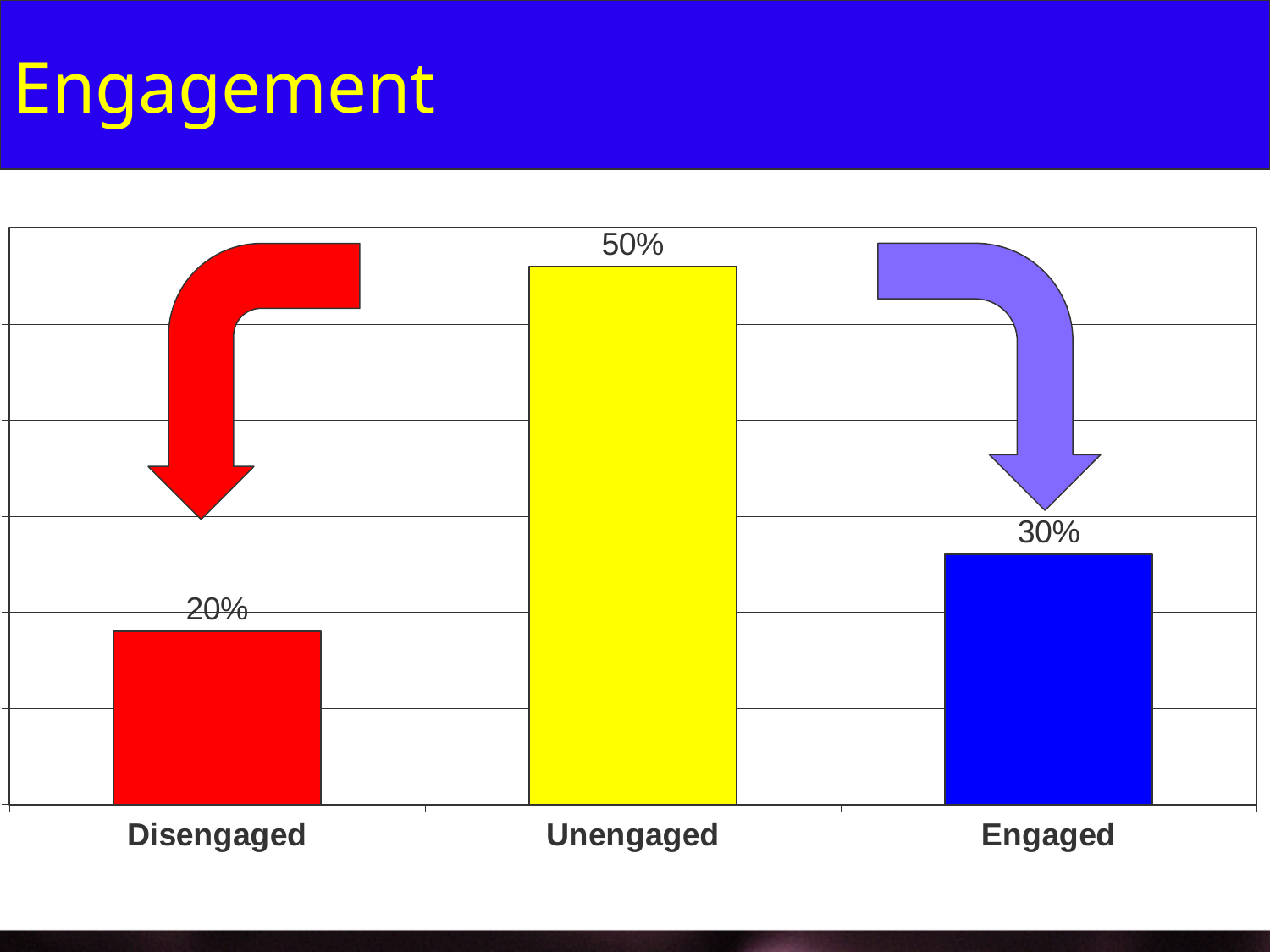
Which category has the lowest value? Disengaged How many categories are shown in the chart? 3 Which category has the highest value? Unengaged What is the difference between the Engaged and Disengaged values? 10% What kind of chart is shown on the slide? Bar chart What is the value for Engaged? 30% What is the difference between the Unengaged and Engaged values? 20% Which is larger, the value for Engaged or the value for Disengaged? Engaged What is the title of the slide containing the chart? Engagement What colour is the bar for Unengaged? Yellow What is the value for Unengaged? 50% What is the value for Disengaged? 20%